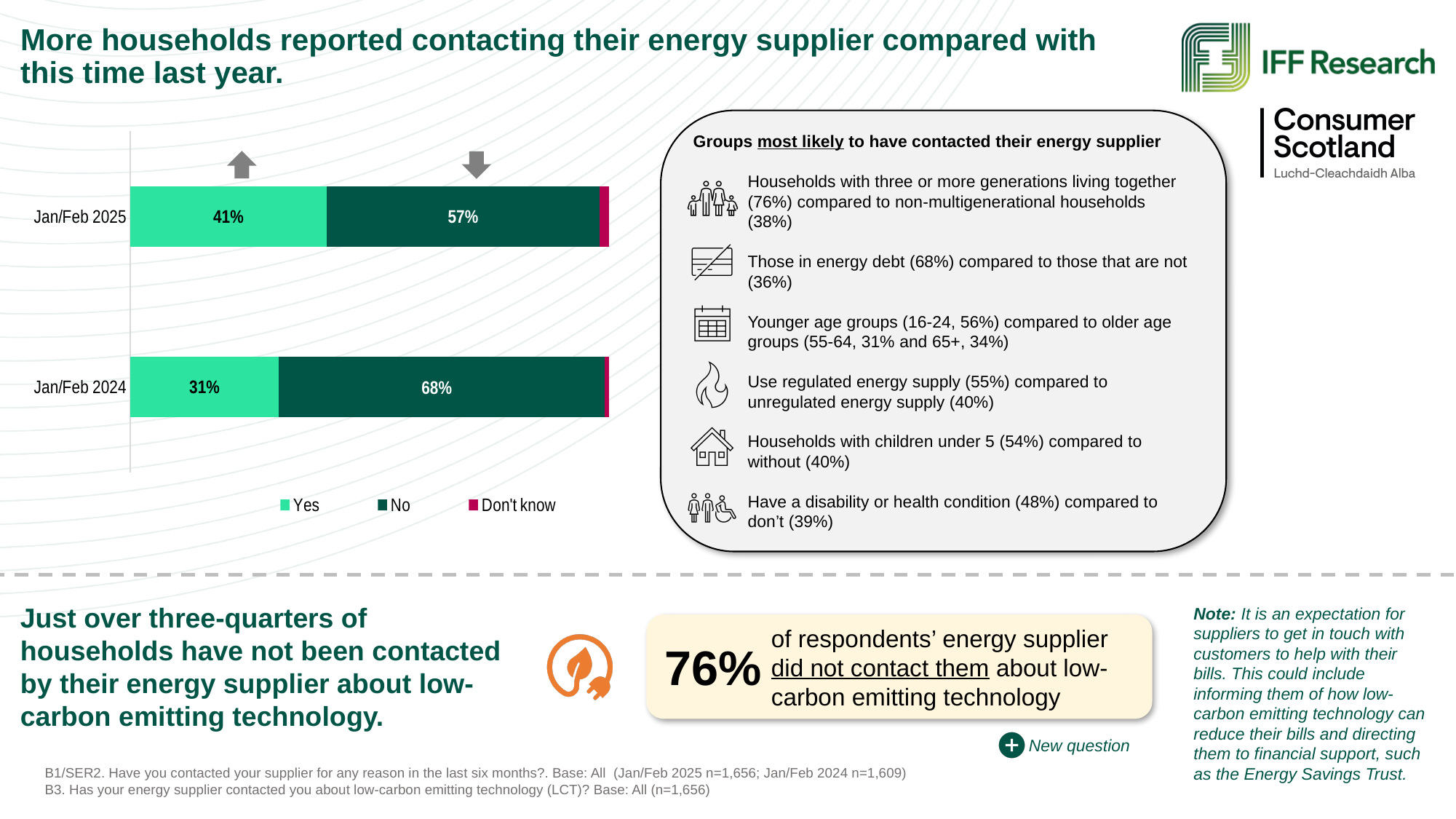
By how many percentage points did the "Yes" share change from Jan/Feb 2024 to Jan/Feb 2025? 10 percentage points What is the difference between the "No" share in Jan/Feb 2024 and in Jan/Feb 2025? 11 percentage points Which period has the higher "No" share? Jan/Feb 2024 What percentage of households answered "Yes" in Jan/Feb 2024? 31% What percentage of households answered "No" in Jan/Feb 2025? 57% Which period has the higher "Yes" share, Jan/Feb 2025 or Jan/Feb 2024? Jan/Feb 2025 What percentage of households answered "No" in Jan/Feb 2024? 68% What percentage of households answered "Yes" in Jan/Feb 2025? 41% How many periods (categories) are shown in the chart? 2 What type of chart is used to show whether households contacted their supplier? Stacked bar chart How many series does the chart legend list? 3 What are the three legend entries in the chart? Yes, No, Don't know